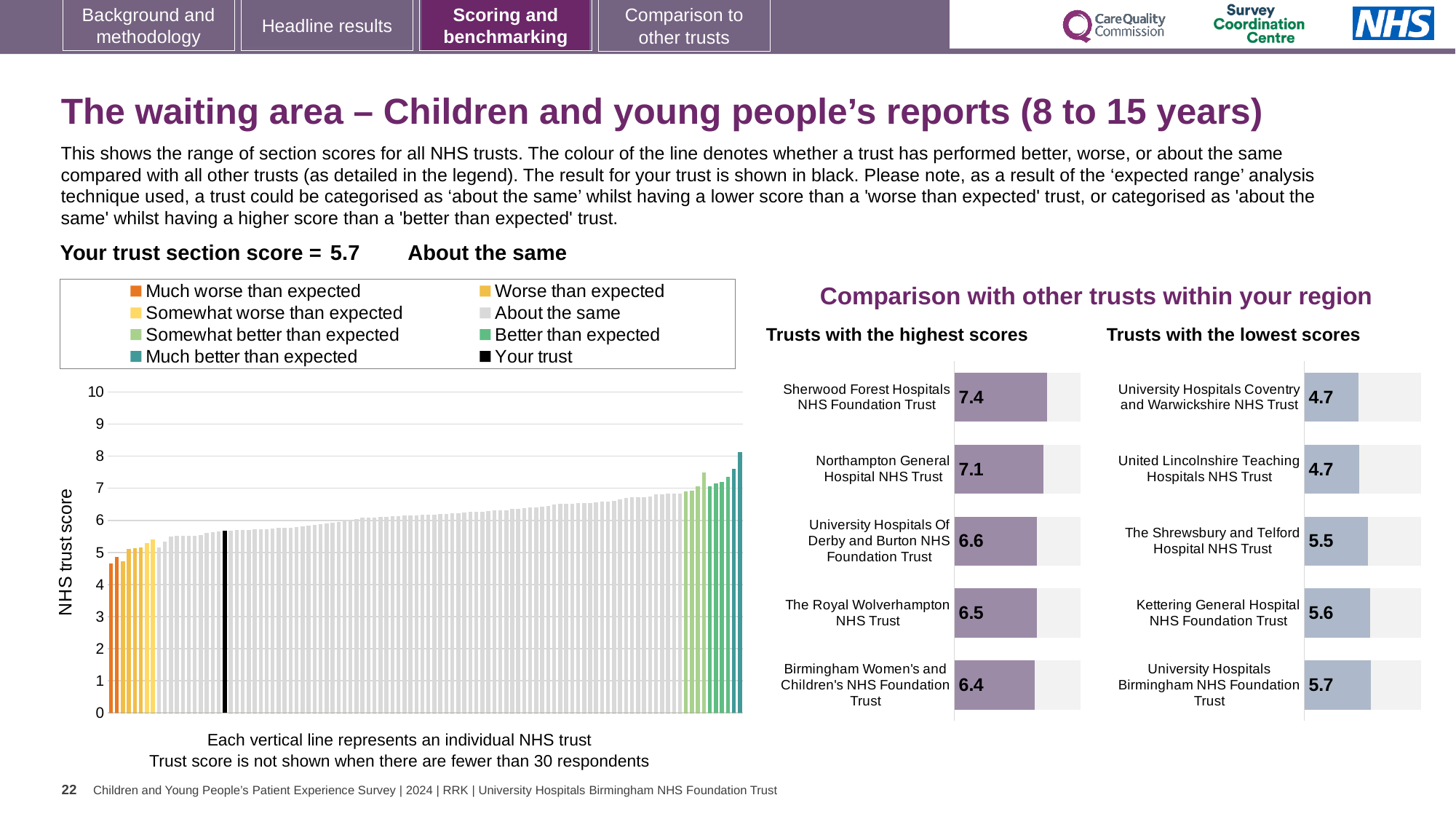
In the 'Trusts with the lowest scores' chart, what is the score for Kettering General Hospital NHS Foundation Trust? 5.6 In the 'Trusts with the lowest scores' chart, what is the score for The Shrewsbury and Telford Hospital NHS Trust? 5.5 In the 'Trusts with the lowest scores' chart, what is the difference between the scores of University Hospitals Birmingham NHS Foundation Trust and United Lincolnshire Teaching Hospitals NHS Trust? 1.0 In the large chart on the left showing all NHS trusts, do the bar values rise or fall from left to right? rise In the 'Trusts with the highest scores' chart, what is the score for Sherwood Forest Hospitals NHS Foundation Trust? 7.4 How many entries does the legend of the large chart on the left list? 8 In the 'Trusts with the highest scores' chart, which trust has the highest score? Sherwood Forest Hospitals NHS Foundation Trust How many trusts are listed in the 'Trusts with the lowest scores' chart? 5 In the 'Trusts with the highest scores' chart, what is the score for The Royal Wolverhampton NHS Trust? 6.5 In the 'Trusts with the highest scores' chart, which has the larger score: Northampton General Hospital NHS Trust or University Hospitals Of Derby and Burton NHS Foundation Trust? Northampton General Hospital NHS Trust In the 'Trusts with the lowest scores' chart, which trust has the highest score shown? University Hospitals Birmingham NHS Foundation Trust In the 'Trusts with the highest scores' chart, what is the difference between the scores of Sherwood Forest Hospitals NHS Foundation Trust and Birmingham Women's and Children's NHS Foundation Trust? 1.0